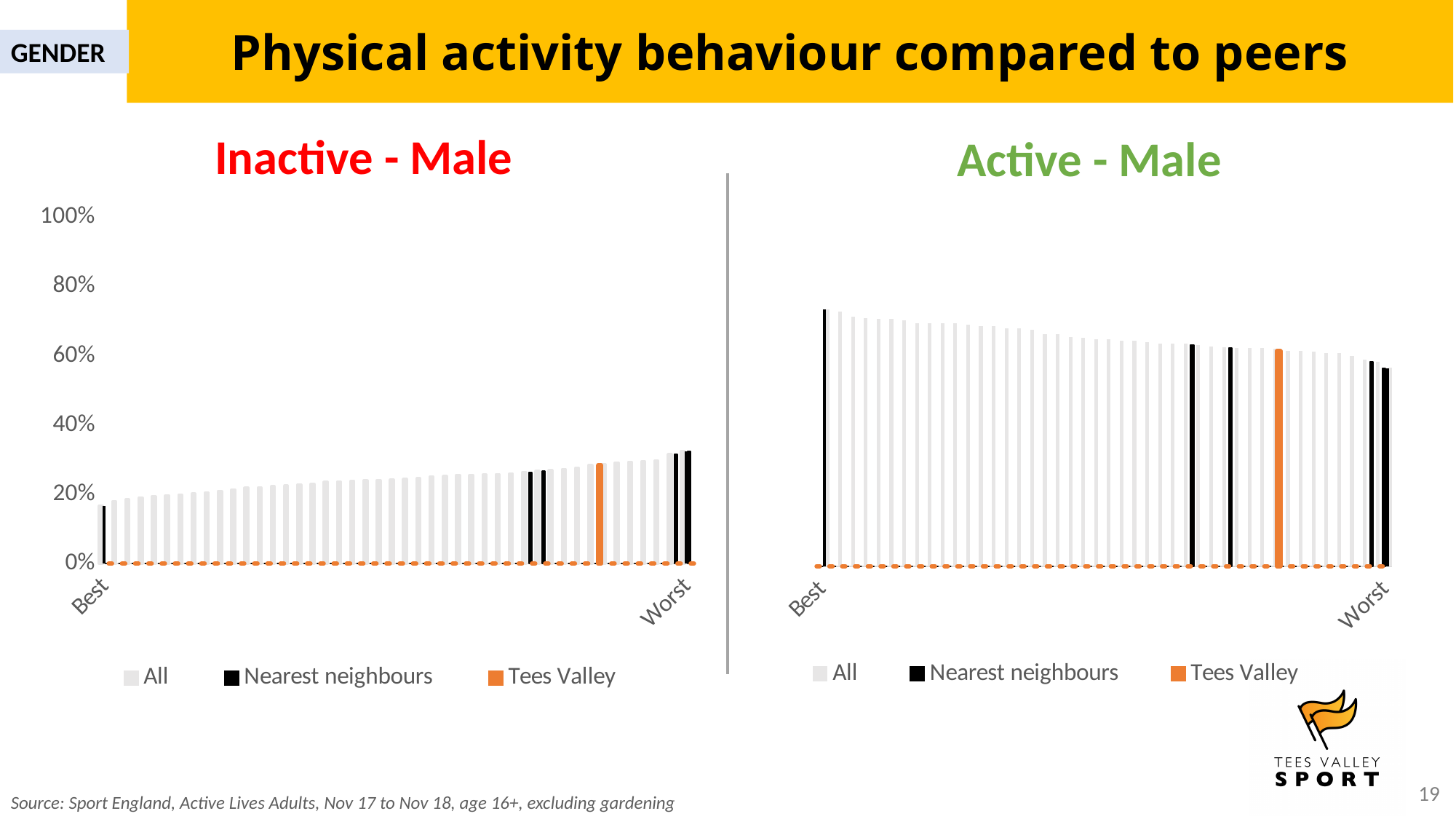
In the Active - Male chart, is the value for Tees Valley greater or less than 80%? less In the Inactive - Male chart, is the value for the Worst area greater or less than 40%? less What colour represents Tees Valley in the charts? orange In the Inactive - Male chart, is the value for Tees Valley greater or less than 20%? greater How many series does the legend of the Active - Male chart list? 3 What kind of chart is the Inactive - Male chart? bar chart What are the legend entries on the Inactive - Male chart? All, Nearest neighbours, Tees Valley In the Active - Male chart, do the values rise or fall from Best to Worst? fall In the Inactive - Male chart, do the values rise or fall from Best to Worst? rise